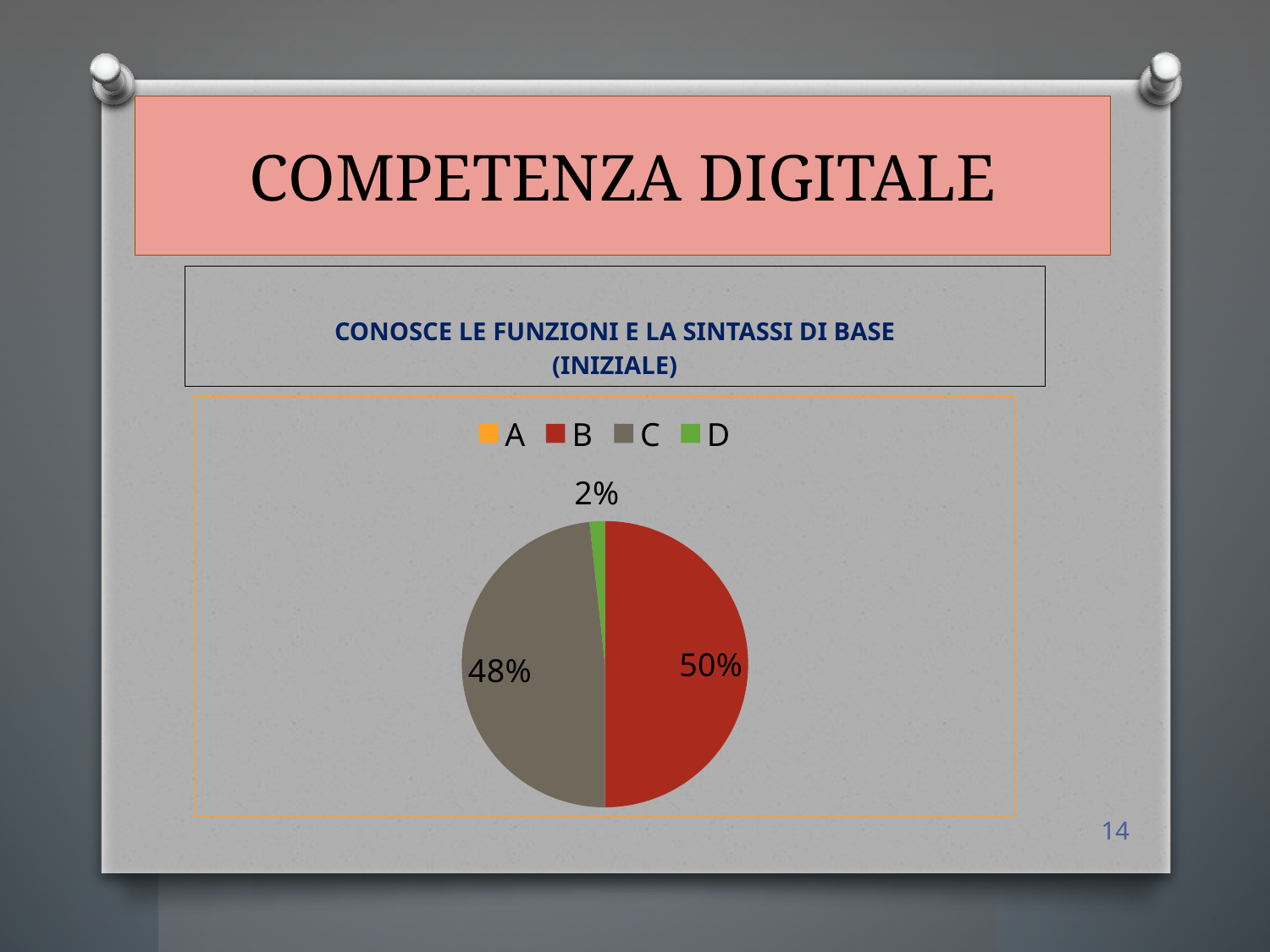
What kind of chart is shown on the slide? pie chart What is the title shown above the pie chart? CONOSCE LE FUNZIONI E LA SINTASSI DI BASE (INIZIALE) What is the difference between the shares of C and D? 46% What share of the pie does category B have? 50% What colour is used for category B in the pie chart? red Which category has the largest slice of the pie? B Which category has the smallest labelled slice of the pie? D Which is larger, the share for B or the share for C? B How many entries does the legend of the pie chart list? 4 What share of the pie does category C have? 48% What is the difference between the shares of B and C? 2% What share of the pie does category D have? 2%